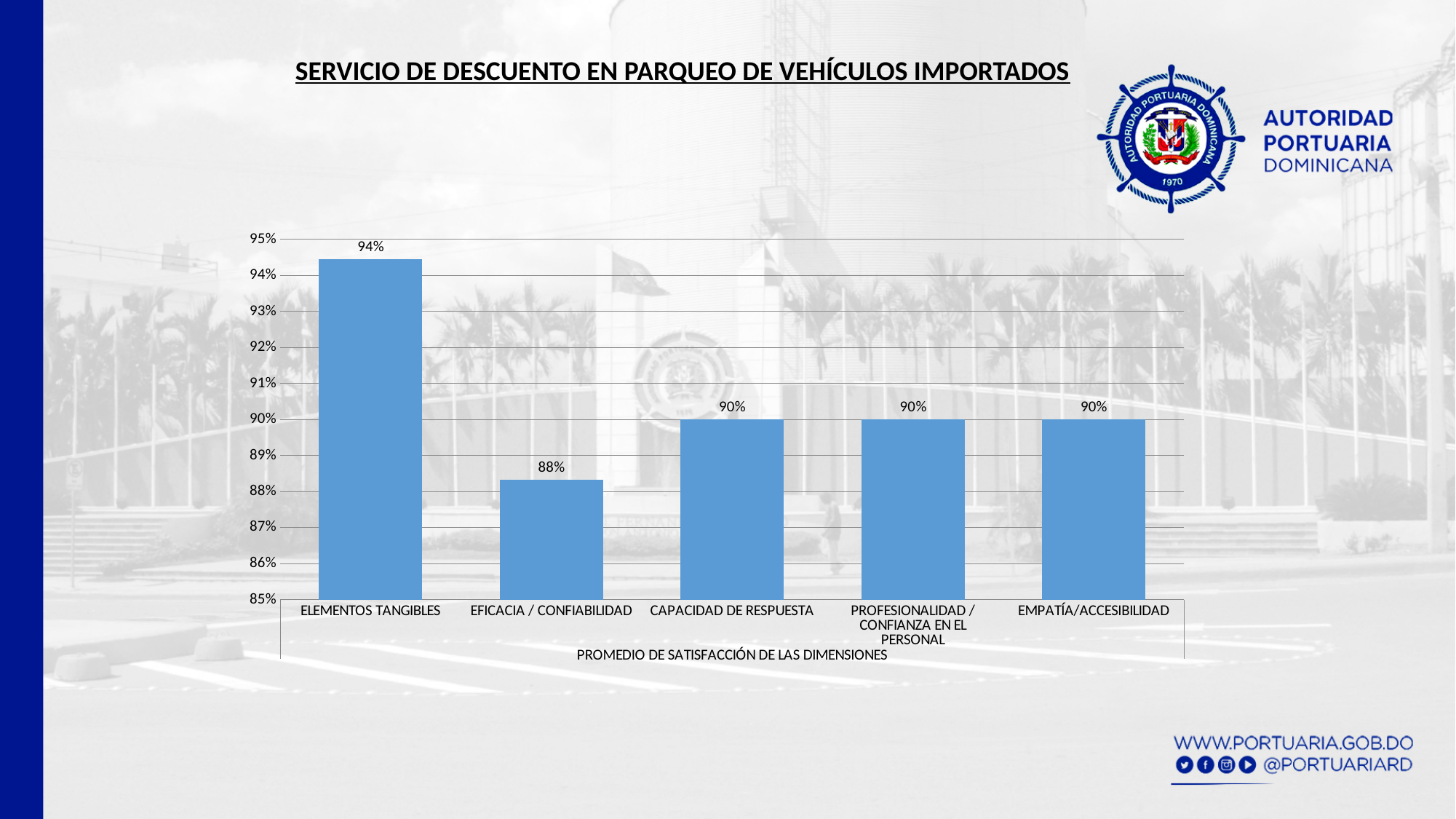
What is the difference between the values for ELEMENTOS TANGIBLES and EFICACIA / CONFIABILIDAD? 6% Which category has the lowest value? EFICACIA / CONFIABILIDAD What is the title of the slide? SERVICIO DE DESCUENTO EN PARQUEO DE VEHÍCULOS IMPORTADOS What is the value for ELEMENTOS TANGIBLES? 94% Which is larger, the value for ELEMENTOS TANGIBLES or the value for CAPACIDAD DE RESPUESTA? ELEMENTOS TANGIBLES Which category has the highest value? ELEMENTOS TANGIBLES What kind of chart is shown on the slide? bar chart What is the value for CAPACIDAD DE RESPUESTA? 90% What is the value for EFICACIA / CONFIABILIDAD? 88% What is the value for EMPATÍA/ACCESIBILIDAD? 90% Is the value for EFICACIA / CONFIABILIDAD greater or less than 90%? less How many categories are shown on the chart? 5